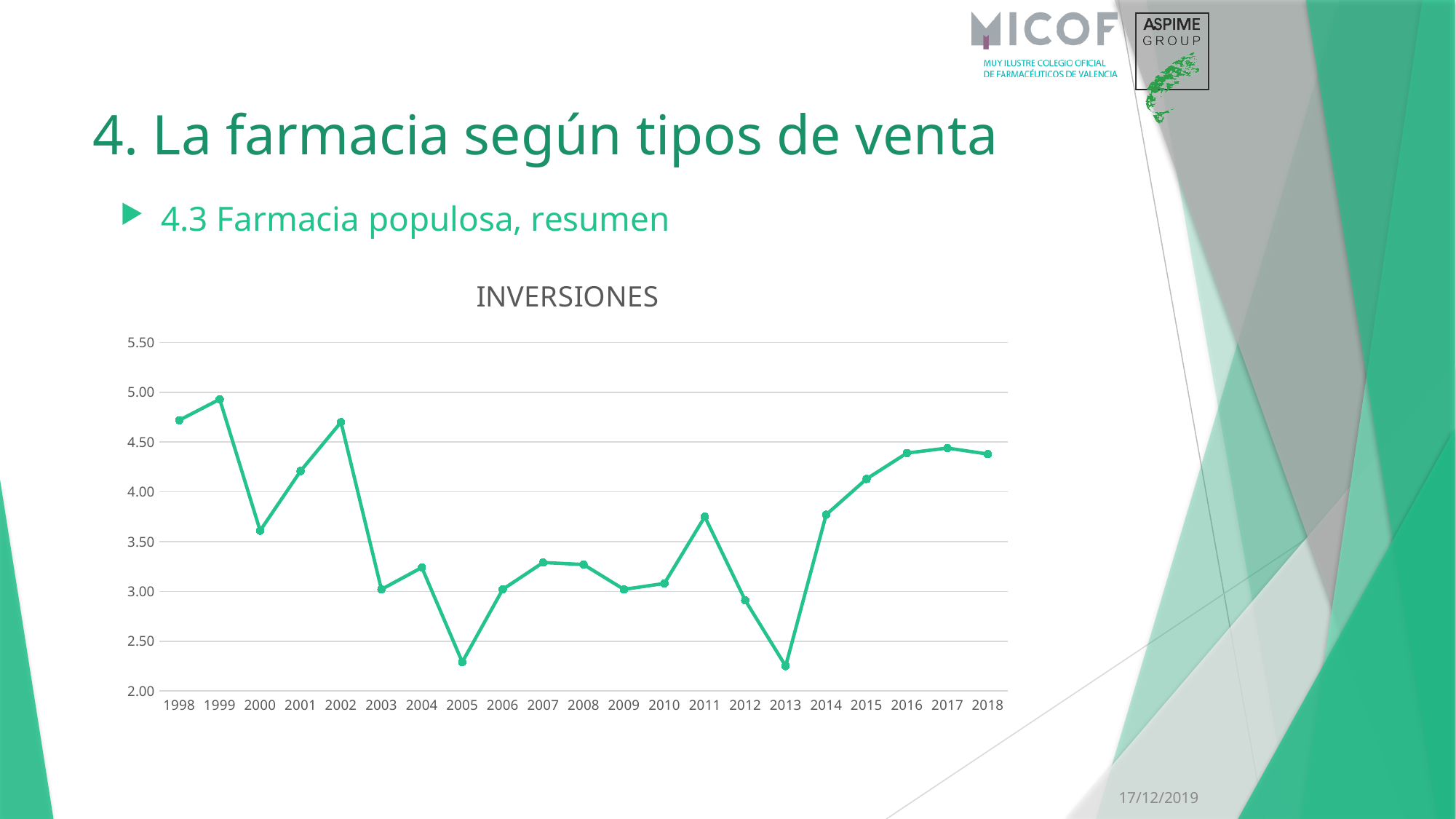
What kind of chart is shown on the slide? line chart Is the value for 2005 greater or less than 2.50? less Is the value for 2015 greater or less than 4.00? greater Which year has the highest value in the INVERSIONES chart? 1999 Is the value for 2011 greater or less than 3.50? greater Which year has the larger value, 1999 or 2000? 1999 How many years are plotted on the x axis of the chart? 21 Which year has the larger value, 2013 or 2014? 2014 What is the title of the chart? INVERSIONES Do the values rise or fall from 2013 to 2017? rise